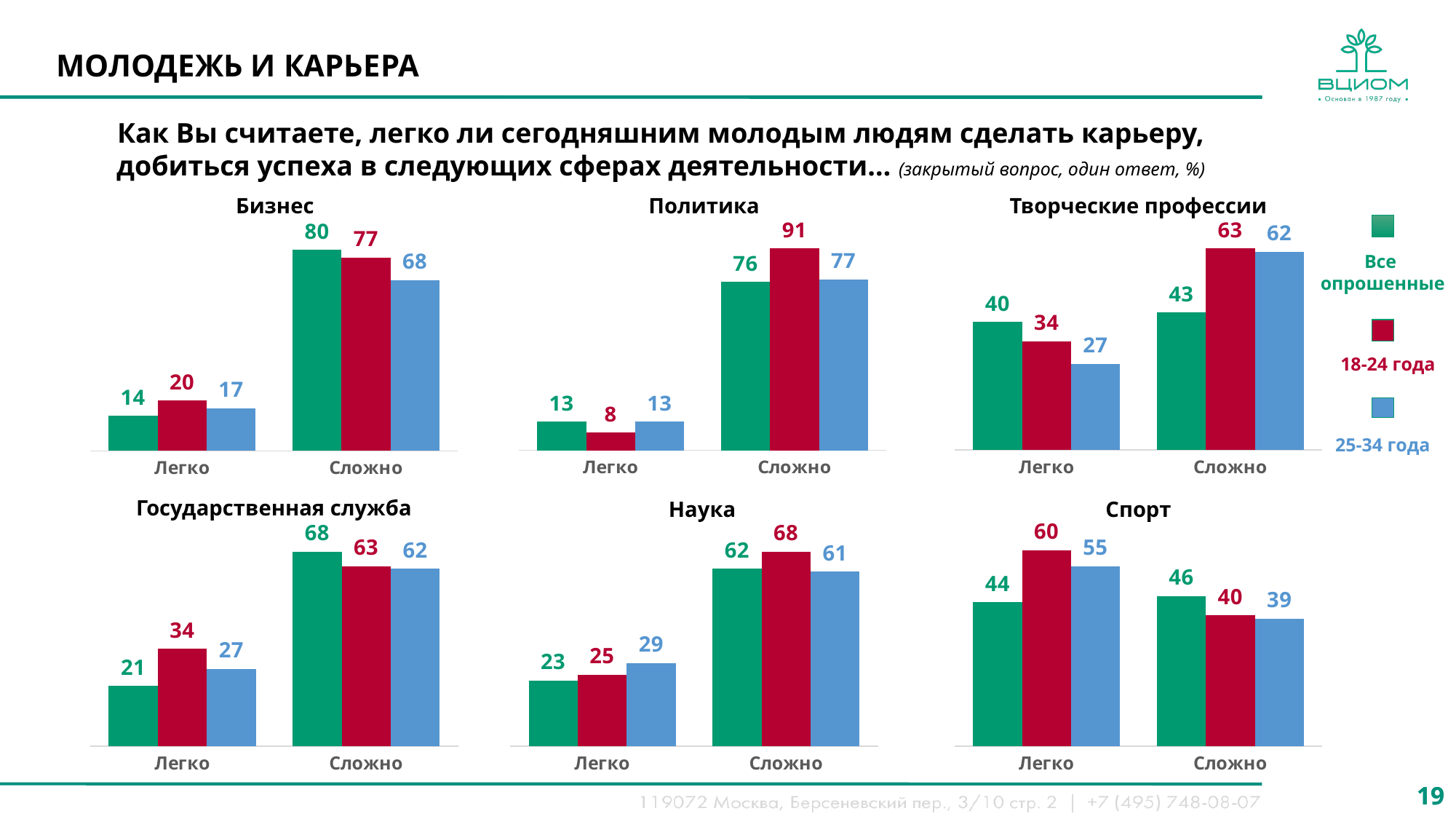
In the "Наука" chart, which is larger in the "Сложно" category: the value for "Все опрошенные" or for "25-34 года"? Все опрошенные In the "Спорт" chart, what is the value for "25-34 года" in the "Легко" category? 55 In the "Бизнес" chart, what is the value for "Все опрошенные" in the "Сложно" category? 80 In the "Политика" chart, what is the value for "18-24 года" in the "Легко" category? 8 Which colour represents the "25-34 года" series in the legend? Blue In the "Спорт" chart, is the value for "18-24 года" in the "Легко" category greater or less than the value for "18-24 года" in the "Сложно" category? greater In the "Творческие профессии" chart, which series has the lowest value in the "Легко" category? 25-34 года How many series does the legend list? 3 How many categories are shown on the x axis of the "Бизнес" chart? 2 What kind of chart is the "Наука" chart? Bar chart In the "Государственная служба" chart, what is the difference between the "18-24 года" and "Все опрошенные" values in the "Легко" category? 13 In the "Политика" chart, which series has the highest value in the "Сложно" category? 18-24 года